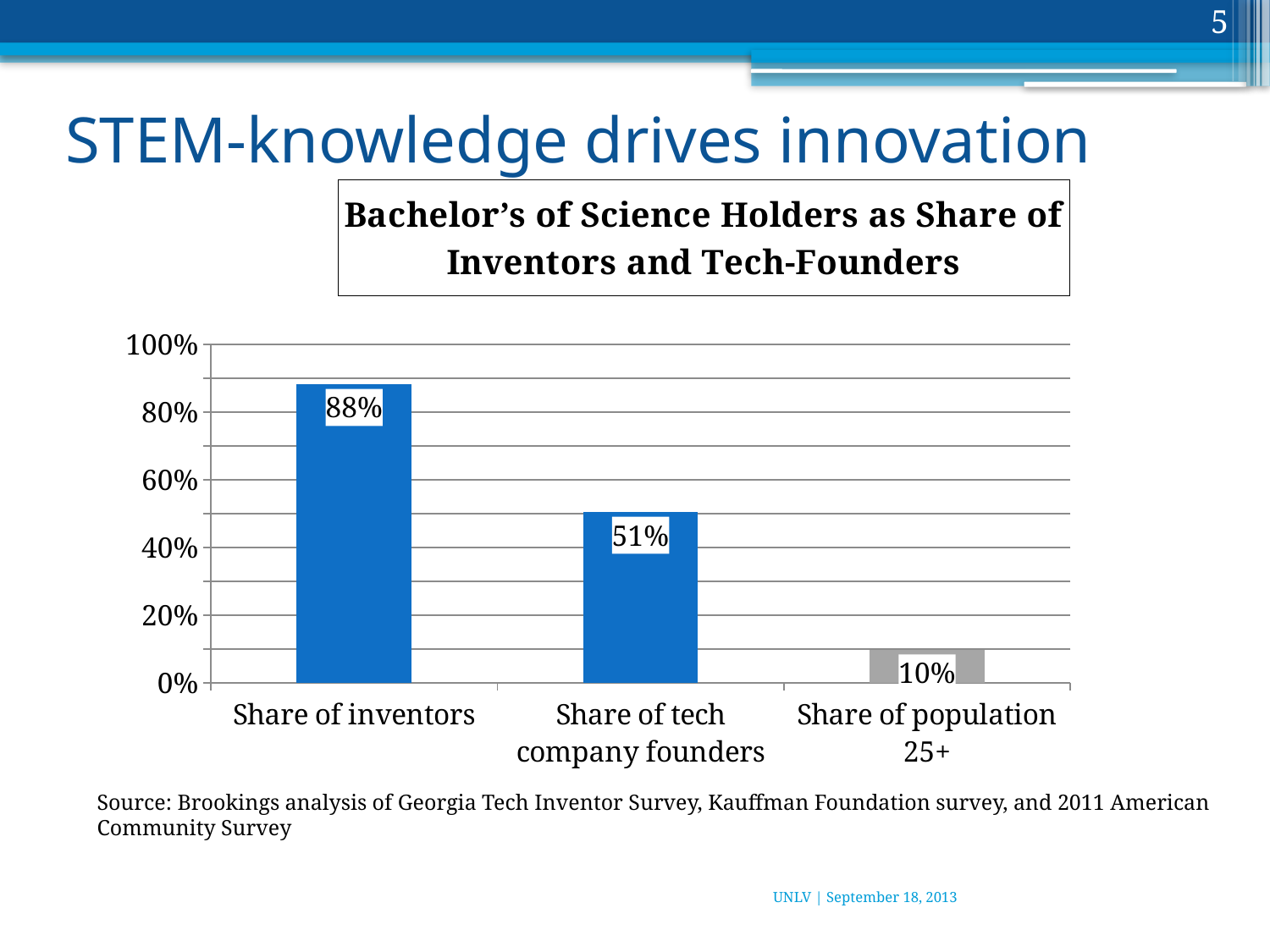
What is the difference between Share of tech company founders and Share of population 25+? 41% Which is larger, Share of tech company founders or Share of population 25+? Share of tech company founders Which category has the lowest value? Share of population 25+ What is the value for Share of inventors? 88% Is the value for Share of tech company founders greater or less than 60%? less How many categories are shown in the chart? 3 What kind of chart is shown on the slide? bar chart Which category has the highest value? Share of inventors What is the value for Share of tech company founders? 51% What is the title of the chart? Bachelor's of Science Holders as Share of Inventors and Tech-Founders What is the difference between Share of inventors and Share of tech company founders? 37% What is the value for Share of population 25+? 10%